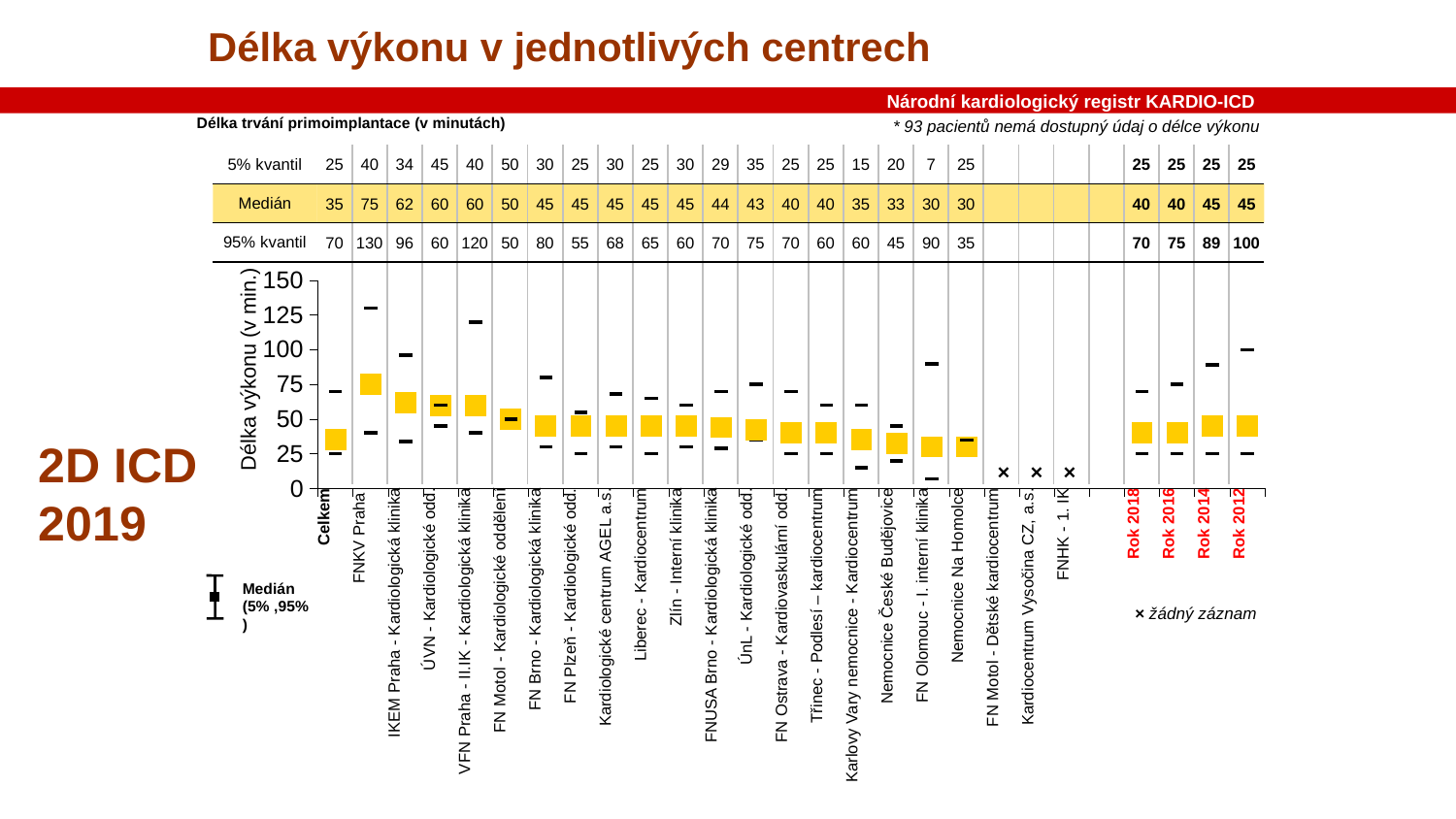
What is the label of the vertical axis of the chart? Délka výkonu (v min.) What is the 95% kvantil value for FNKV Praha? 130 What is the 5% kvantil value for FN Olomouc - I. interní klinika? 7 Which centre has the highest median procedure duration? FNKV Praha How many centres are marked with × (žádný záznam) on the chart? 3 What is the difference between the median for FNKV Praha and the median for Celkem? 40 Which centre has the lowest 5% kvantil value? FN Olomouc - I. interní klinika What is the median (Medián) value for Celkem? 35 What is the 95% kvantil value for Rok 2012? 100 According to the legend, what does the × symbol mean? žádný záznam Which has the higher median: IKEM Praha - Kardiologická klinika or ÚVN - Kardiologické odd.? IKEM Praha - Kardiologická klinika What is the median (Medián) procedure duration for FNKV Praha? 75